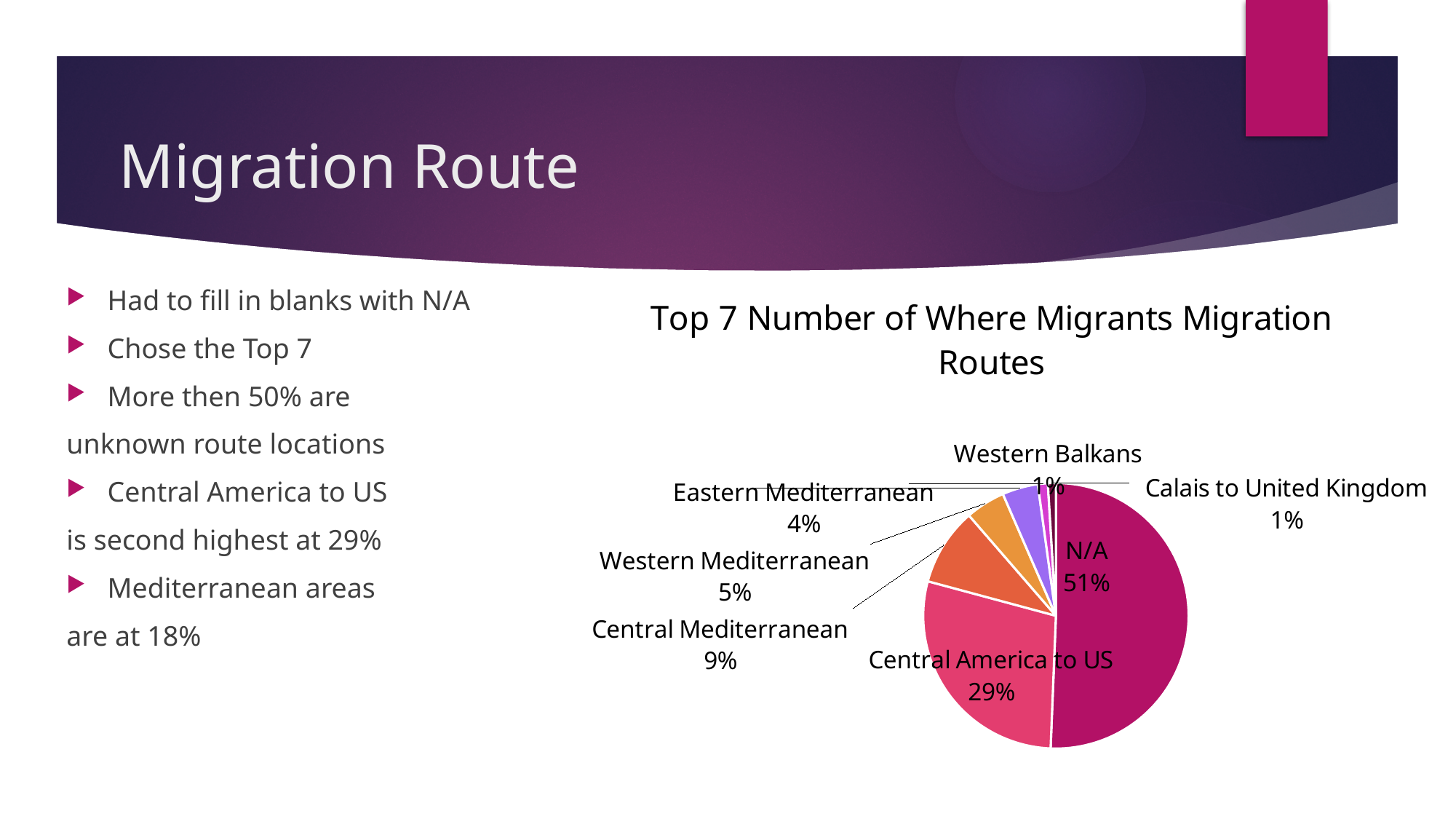
What percentage is shown for Western Mediterranean? 5% What share of the pie does N/A represent? 51% What share of the pie does Central America to US represent? 29% What percentage is shown for Eastern Mediterranean? 4% What kind of chart is shown on the slide? Pie chart Which is larger, Central Mediterranean or Western Mediterranean? Central Mediterranean Which category has the largest slice of the pie? N/A What is the title of the chart? Top 7 Number of Where Migrants Migration Routes What is the difference in percentage points between N/A and Central America to US? 22 What percentage is shown for Central Mediterranean? 9% What percentage is shown for Western Balkans? 1% How many slices does the pie chart have? 7